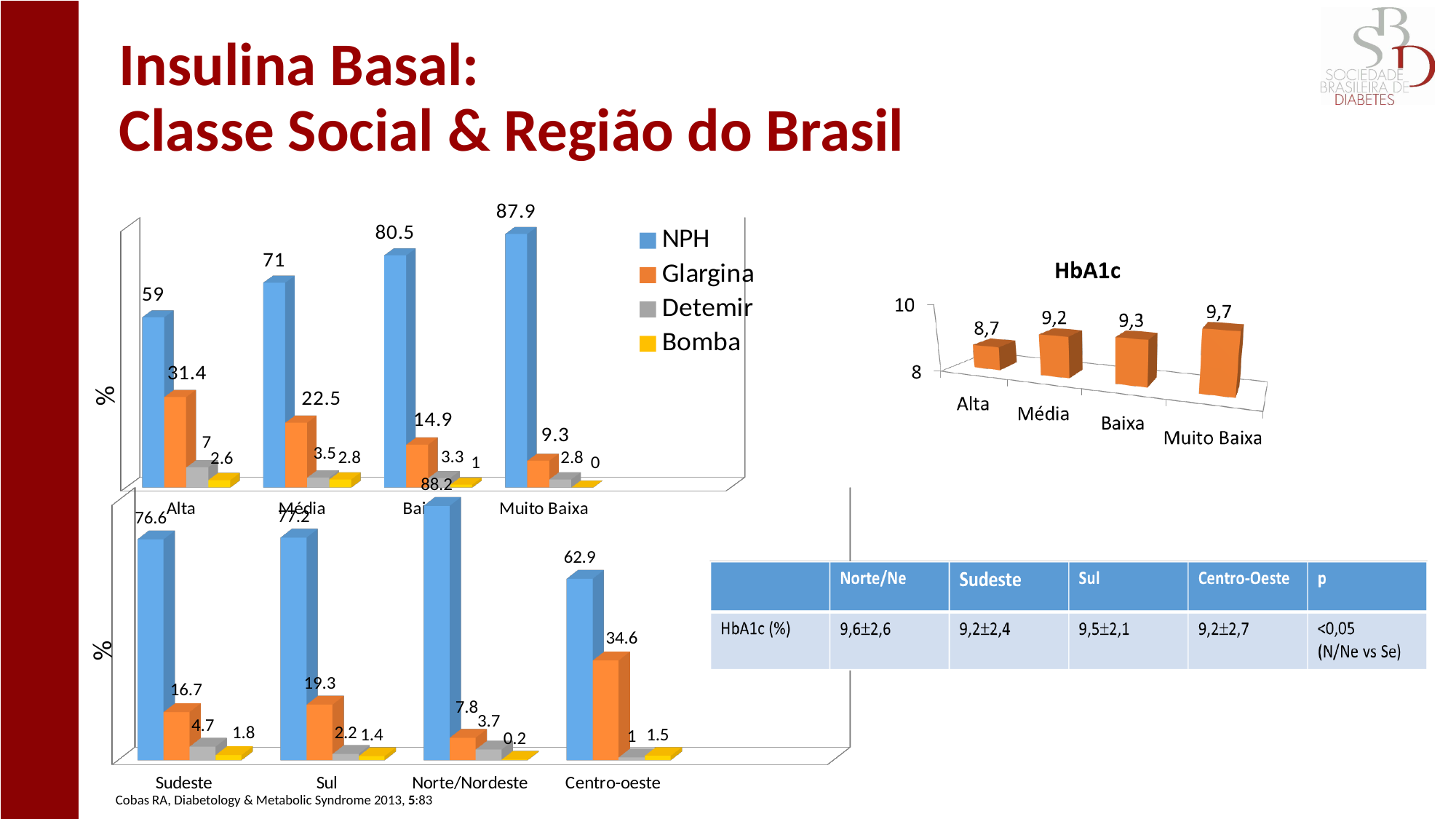
In the top-left chart (by social class), what is the NPH value for Muito Baixa? 87.9 In the top-left chart (by social class), what is the difference between the NPH values for Média and Alta? 12 In the bottom-left chart (by region), which is larger, the Glargina value for Sul or for Sudeste? Sul What kind of chart is the HbA1c chart? bar chart In the top-left chart (by social class), what is the Glargina value for Alta? 31.4 In the bottom-left chart (by region), what is the Bomba value for Norte/Nordeste? 0.2 In the top-left chart (by social class), how many series does the legend list? 4 In the bottom-left chart (by region), what is the Glargina value for Centro-oeste? 34.6 In the HbA1c chart, do the values rise or fall from Alta to Muito Baixa? rise In the HbA1c chart, what is the value for Muito Baixa? 9,7 In the top-left chart (by social class), which category has the highest NPH value? Muito Baixa In the bottom-left chart (by region), which region has the lowest NPH value? Centro-oeste